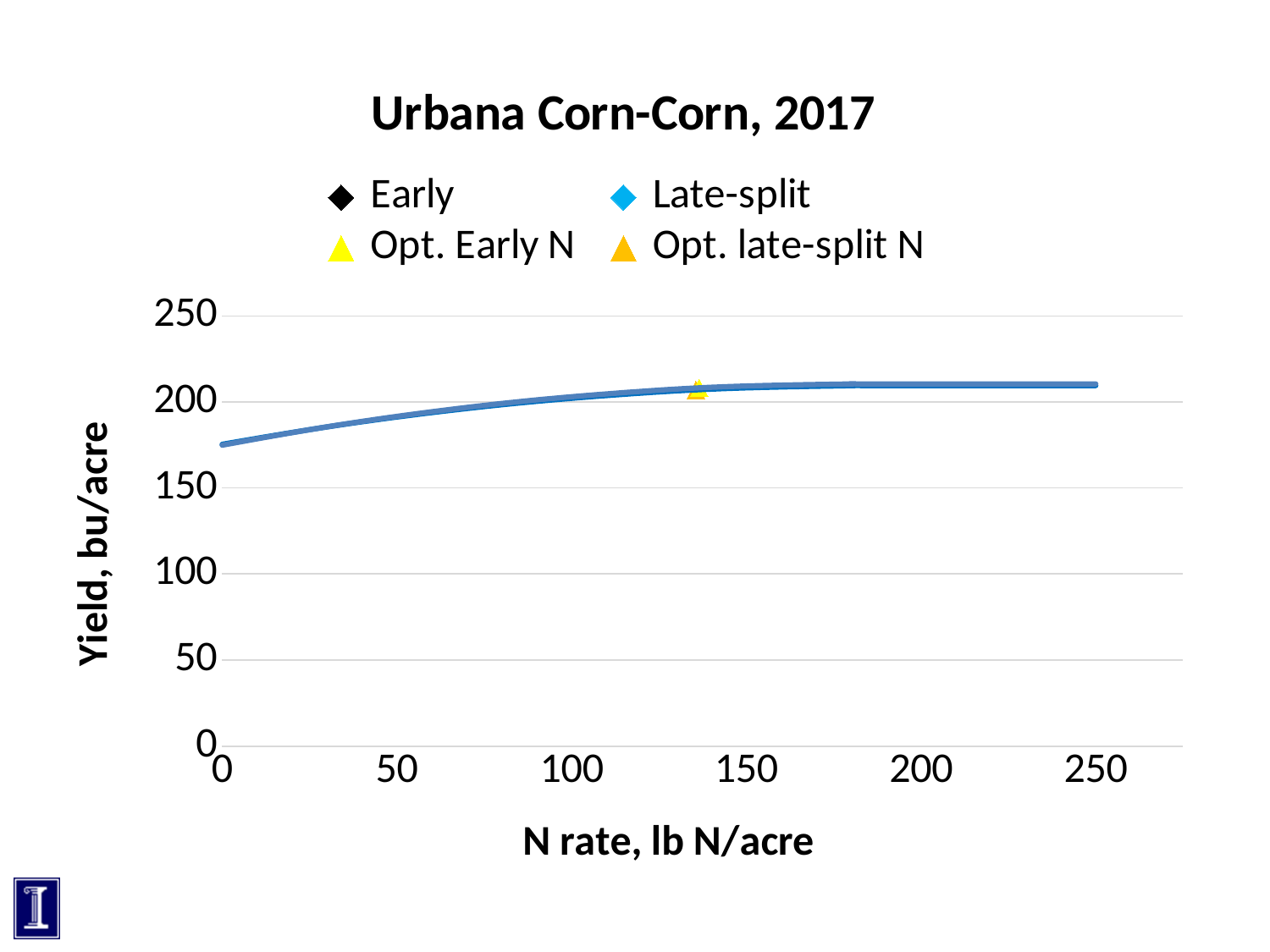
How many series does the legend list? 4 Is the Opt. late-split N marker located at an N rate greater or less than 150? less Is the yield at an N rate of 0 greater or less than 150? greater Is the Opt. Early N marker located at an N rate greater or less than 100? greater Which is larger, the yield at an N rate of 0 or the yield at an N rate of 250? 250 Does yield rise or fall as N rate increases along the x axis? rise What kind of chart is shown on the slide? line chart What is the title of the chart? Urbana Corn-Corn, 2017 What is the label of the y axis? Yield, bu/acre